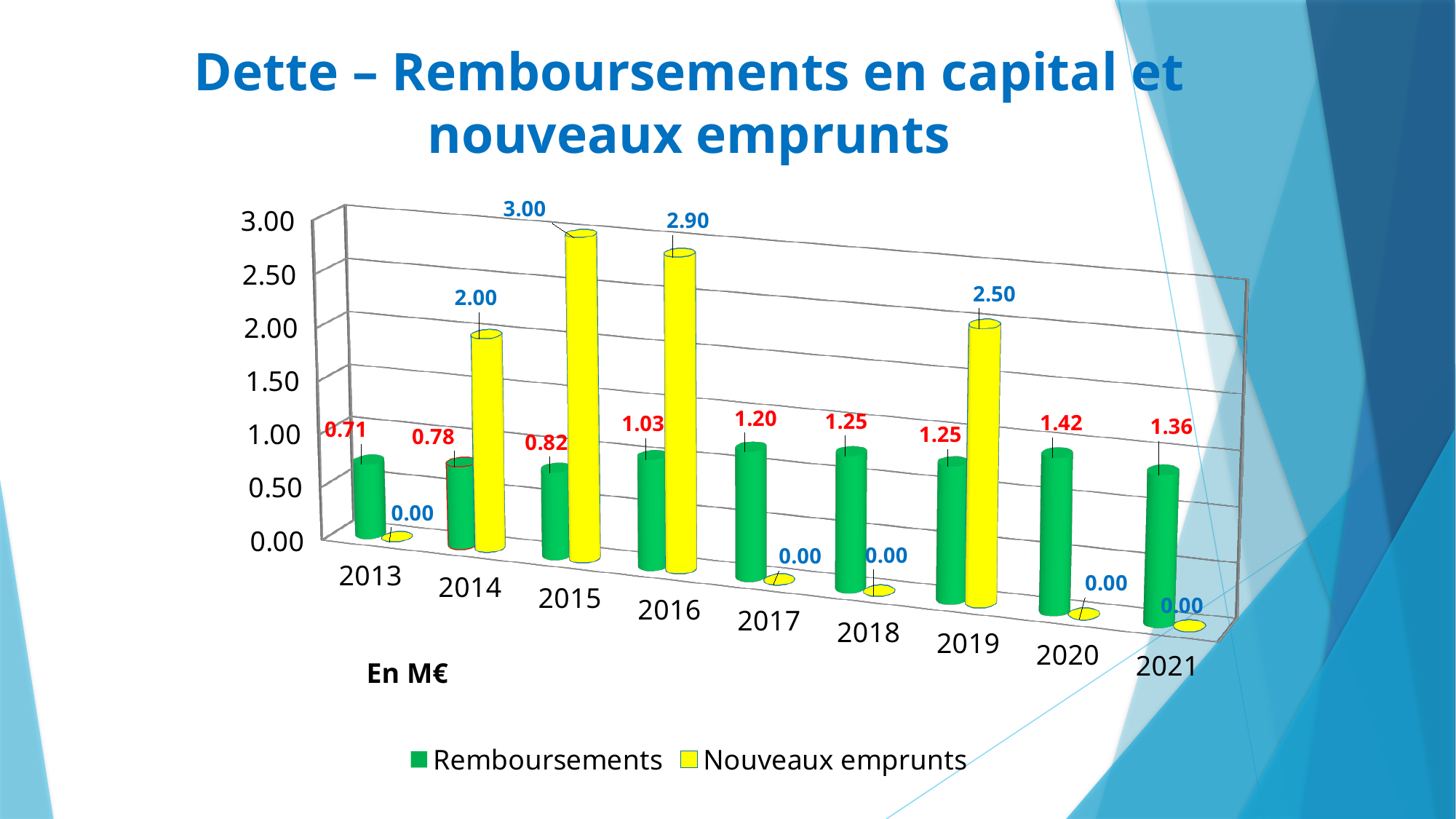
What is the Nouveaux emprunts value for 2019? 2.50 What unit is indicated below the chart? En M€ In which year is the Remboursements value lowest? 2013 What is the Remboursements value for 2020? 1.42 What is the difference between the Remboursements values for 2020 and 2021? 0.06 In which year is the Nouveaux emprunts value highest? 2015 What is the Remboursements value for 2016? 1.03 What is the difference between the Nouveaux emprunts values for 2015 and 2016? 0.10 What kind of chart is shown on the slide? Bar chart How many years are shown on the x axis? 9 Which is larger in 2014: Remboursements or Nouveaux emprunts? Nouveaux emprunts How many series does the legend list? 2